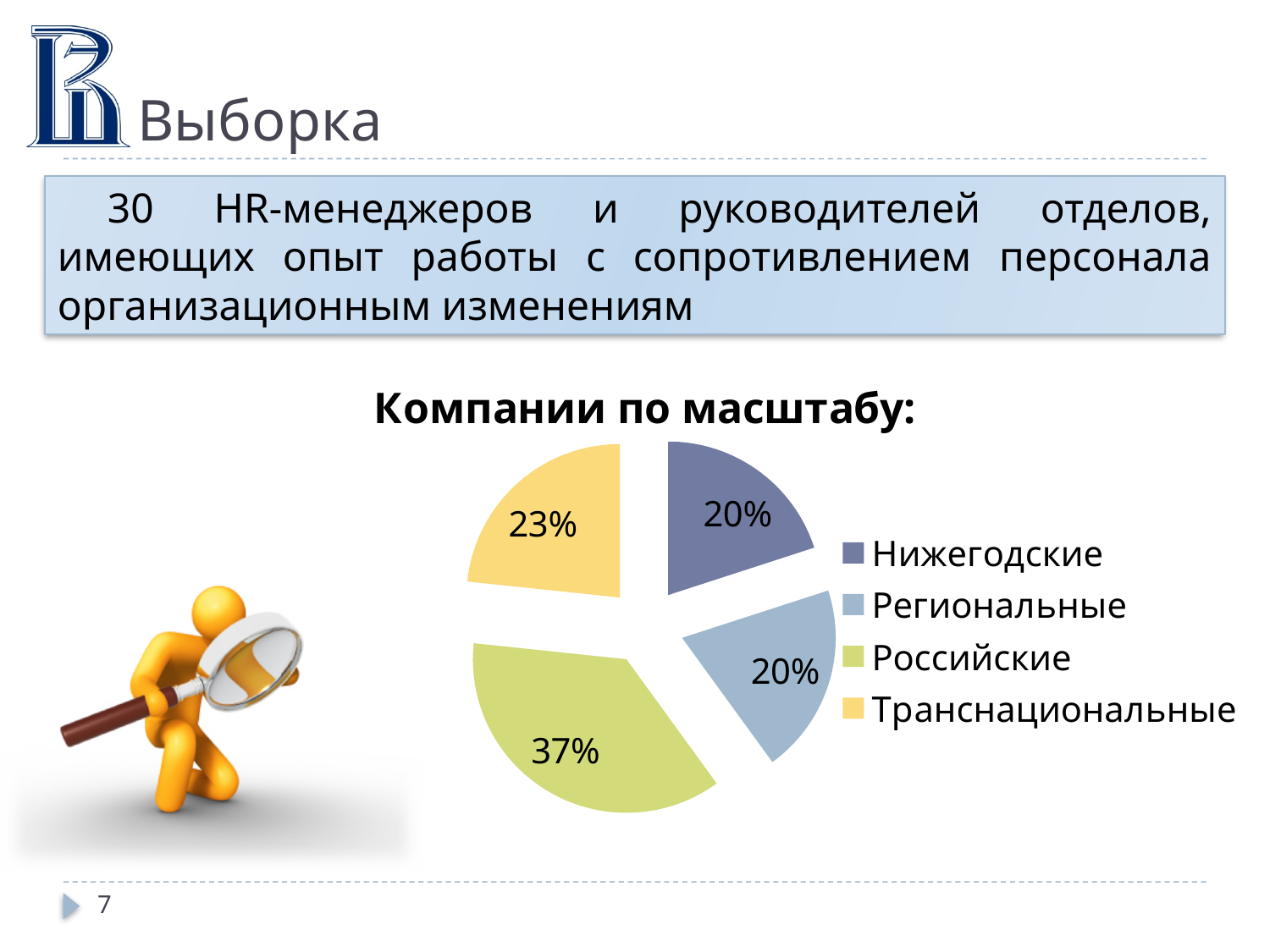
How many slices does the pie chart have? 4 What type of chart is shown on the slide? pie chart What is the difference between the shares for Российские and Транснациональные? 14% Which category has the largest slice of the pie? Российские What share of the pie is labelled Нижегодские? 20% Which is larger, the share for Транснациональные or the share for Нижегодские? Транснациональные What is the title of the chart? Компании по масштабу: How many entries does the legend list? 4 What share of the pie is labelled Региональные? 20% What share of the pie is labelled Российские? 37% Which legend entry is shown in yellow? Транснациональные What share of the pie is labelled Транснациональные? 23%